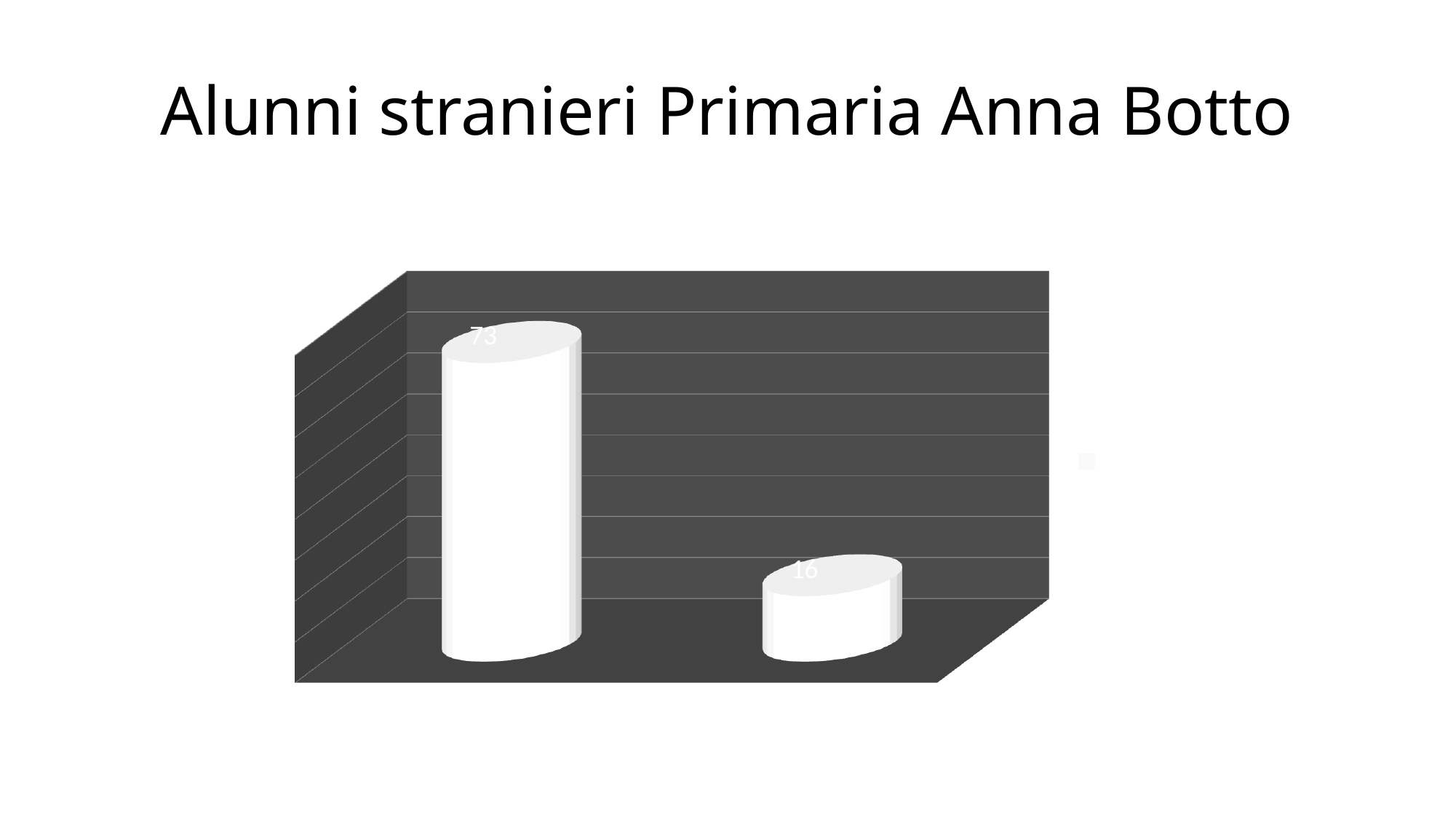
What value is labelled on the left bar of the chart? 73 What is the difference between the values of the left bar and the right bar? 57 What value is labelled on the right bar of the chart? 16 Do the values fall or rise from the left bar to the right bar? fall What is the title of the chart on the slide? Alunni stranieri Primaria Anna Botto How many bars are plotted in the chart? 2 Which bar has the lowest value, the left or the right one? right What is the total of the two bar values shown in the chart? 89 Which bar has the highest value, the left or the right one? left Is the value of the left bar larger or smaller than the value of the right bar? larger What kind of chart is shown on the slide? bar chart